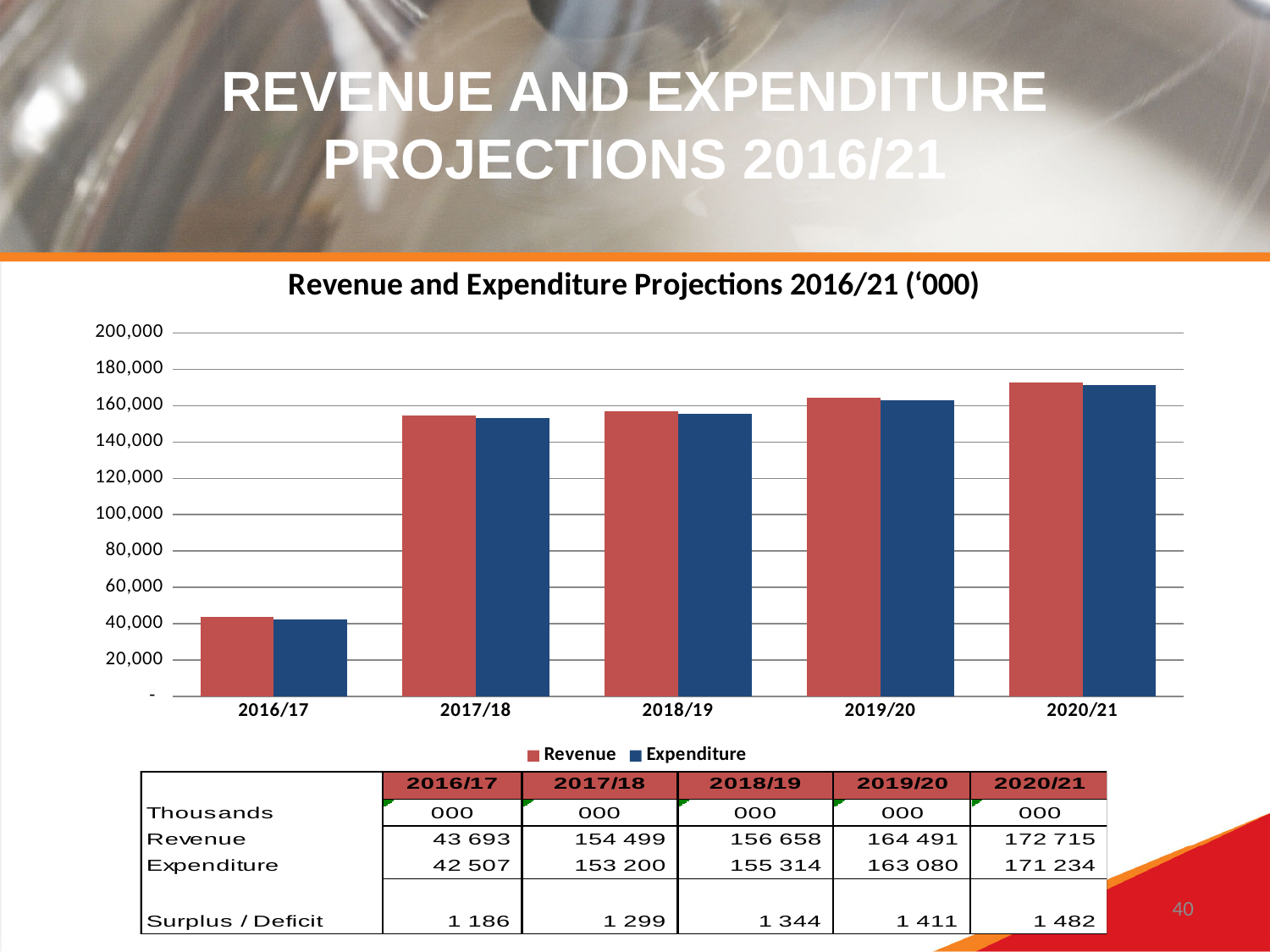
Do the Revenue values rise or fall from 2016/17 to 2020/21? rise What is the Revenue value for 2016/17? 43 693 What is the Revenue value for 2017/18? 154 499 What is the difference between Revenue and Expenditure in 2020/21? 1 482 What kind of chart is shown on the slide? bar chart How many financial years are shown on the x axis? 5 Is the Revenue value for 2018/19 greater or less than 140,000? greater What is the Expenditure value for 2019/20? 163 080 What is the title of the chart? Revenue and Expenditure Projections 2016/21 ('000) How many series does the legend list? 2 Which year has the lowest Expenditure? 2016/17 Which year has the highest Revenue? 2020/21